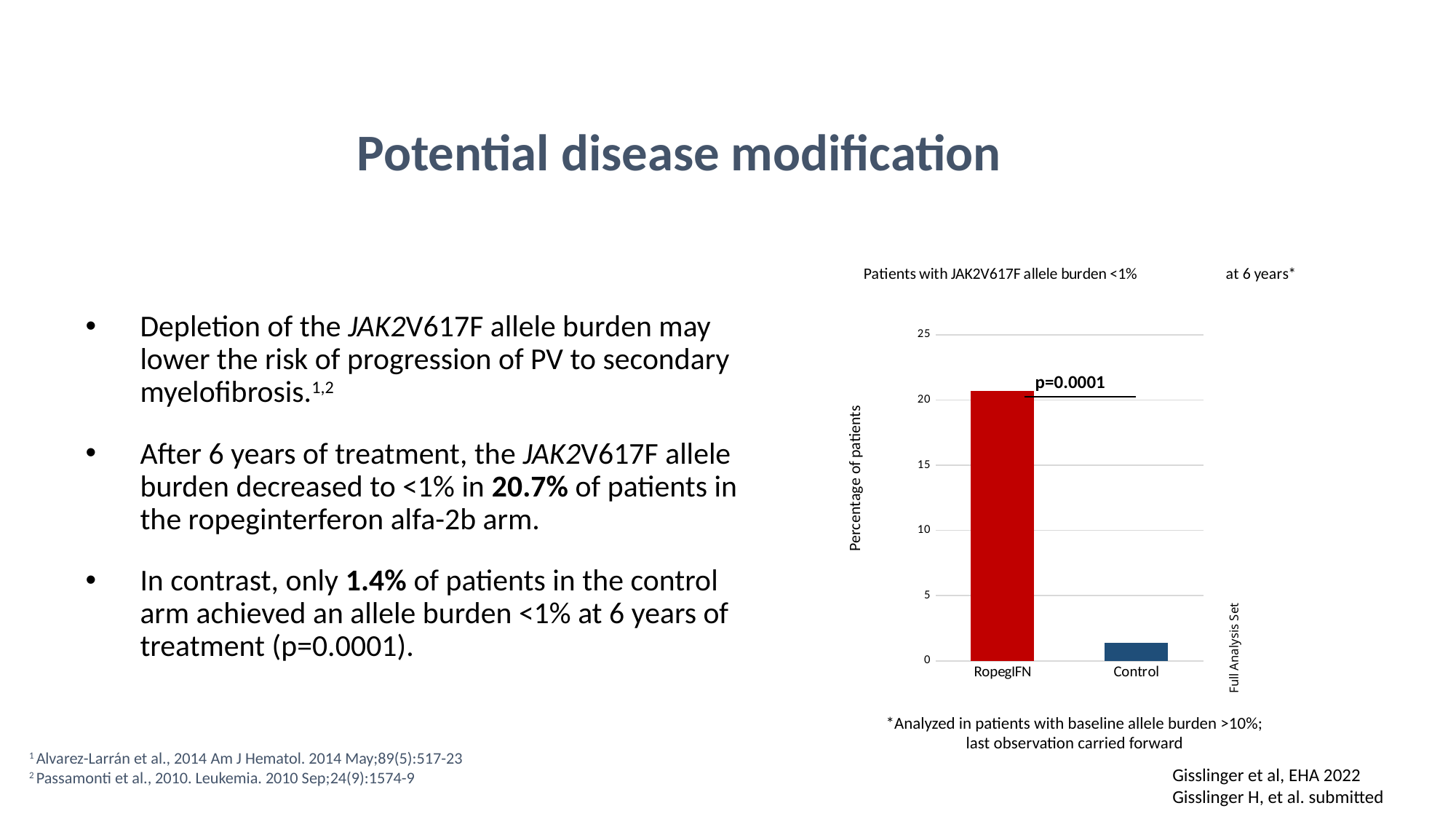
Which category has the highest bar in the chart? RopegIFN How many categories are plotted on the x axis of the chart? 2 What p-value is printed above the bars in the chart? p=0.0001 Is the value for RopegIFN greater or less than 25? less What kind of chart is shown on the slide? bar chart What is the label of the y axis of the chart? Percentage of patients Is the value for Control greater or less than 5? less Which category has the lowest bar in the chart? Control Is the value for RopegIFN greater or less than 20? greater Which bar is taller, RopegIFN or Control? RopegIFN